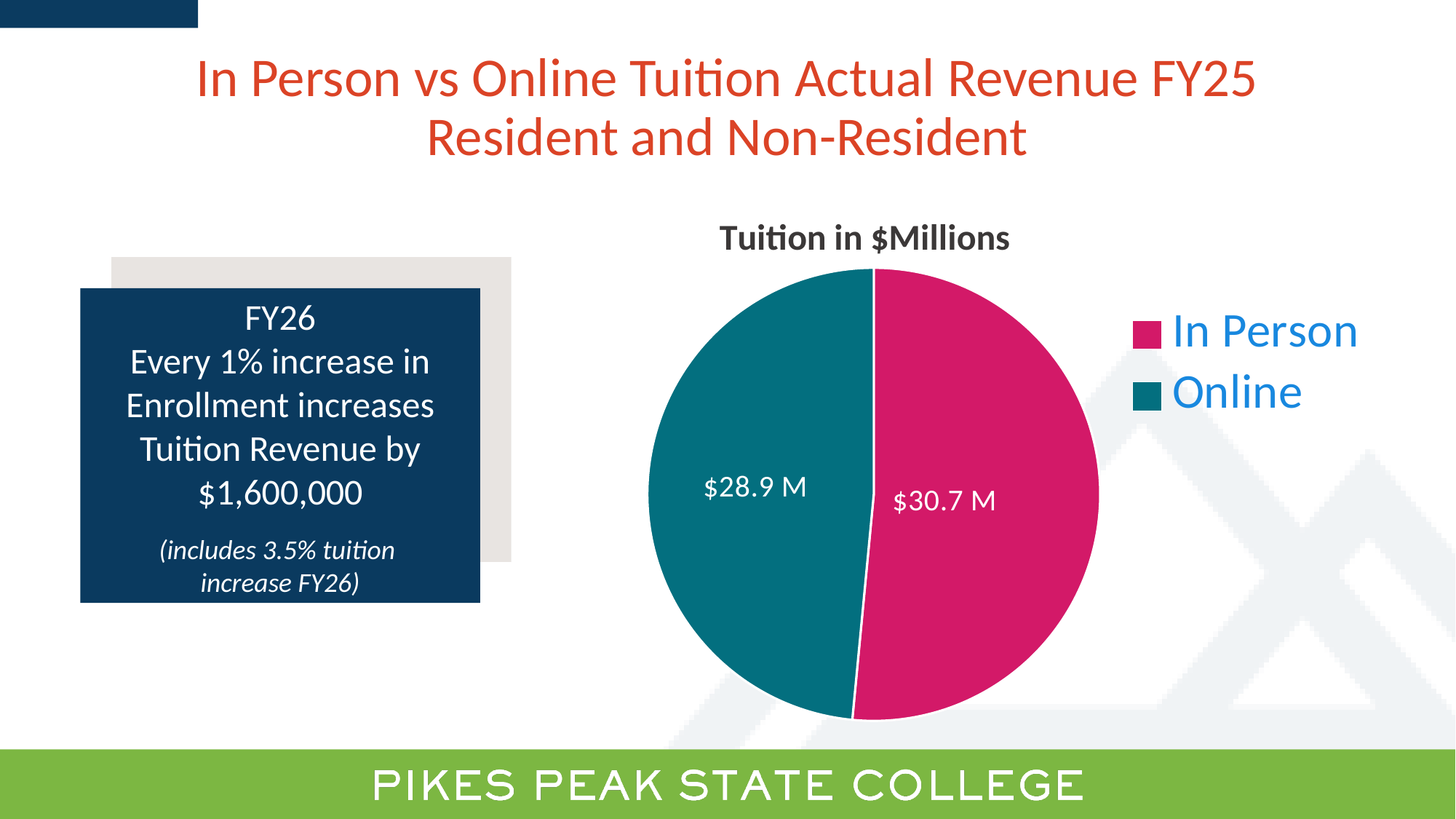
What is the value of the Online slice in the pie chart? $28.9 M What share of the pie chart total does the In Person slice represent? 51.5% What kind of chart is shown on the slide? pie chart What is the total of the two slices in the pie chart? $59.6 M Which category has the larger slice in the pie chart? In Person What is the title of the pie chart? Tuition in $Millions Which category has the smaller slice in the pie chart? Online How many entries does the legend of the pie chart list? 2 What is the value of the In Person slice in the pie chart? $30.7 M What is the difference between the In Person and Online values in the pie chart? $1.8 M How many slices does the pie chart have? 2 Is the Online value larger or smaller than the In Person value in the pie chart? smaller